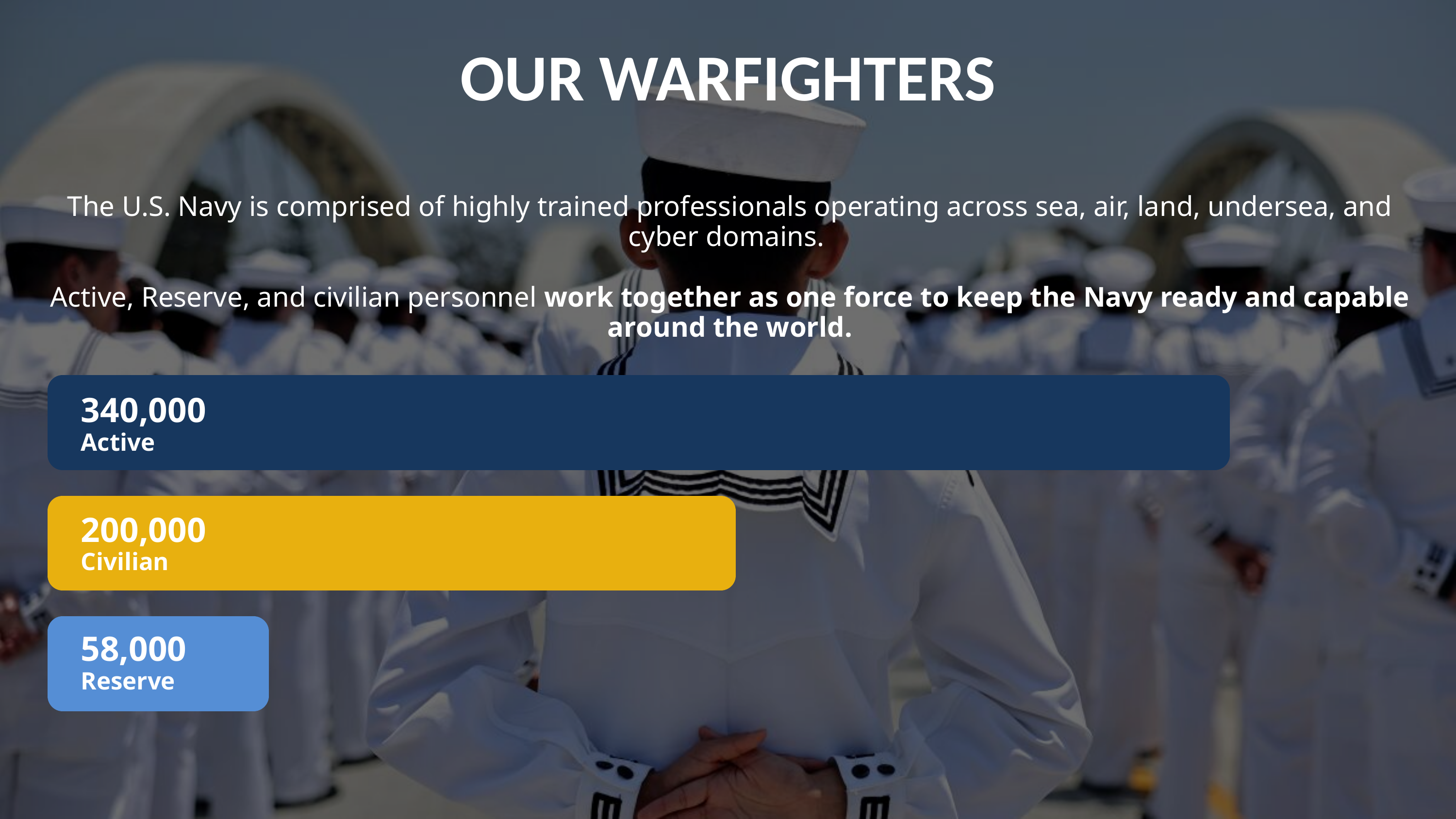
What colour is the Civilian bar? Yellow What is the difference between the Civilian and Reserve values? 142,000 What kind of chart is shown on the slide? Bar chart What is the value shown for Civilian personnel? 200,000 Which is larger, the Civilian value or the Reserve value? Civilian Which category has the highest value? Active Which category has the lowest value? Reserve What is the total of the Active, Civilian and Reserve values? 598,000 What is the value shown for Active personnel? 340,000 How many categories are shown in the chart? 3 What is the difference between the Active and Civilian values? 140,000 What is the value shown for Reserve personnel? 58,000